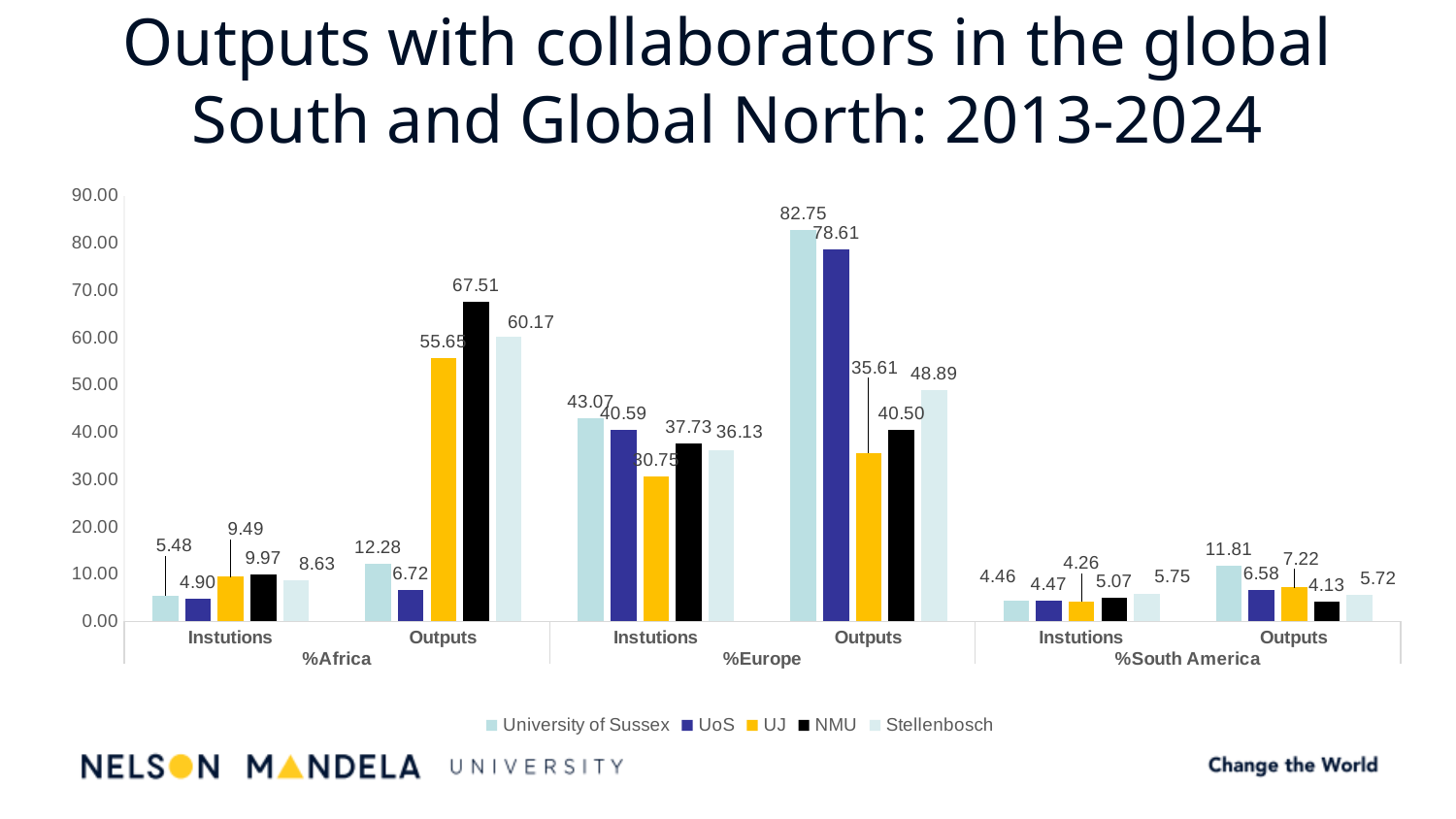
What kind of chart is shown on the slide? Bar chart What is the value for Stellenbosch in the %South America Instutions category? 5.75 What is the value for UJ in the %Europe Instutions category? 30.75 What is the value for University of Sussex in the %Europe Outputs category? 82.75 What is the difference between University of Sussex and UoS in the %Europe Outputs category? 4.14 Which series has the highest value in the %Africa Outputs category? NMU Which series has the lowest value in the %South America Outputs category? NMU Which is larger in the %Europe Instutions category: University of Sussex or NMU? University of Sussex Is the value for Stellenbosch in the %Africa Outputs category greater or less than 50.00? greater How many series does the legend list? 5 What is the value for NMU in the %Africa Outputs category? 67.51 What colour are the UJ bars? Yellow